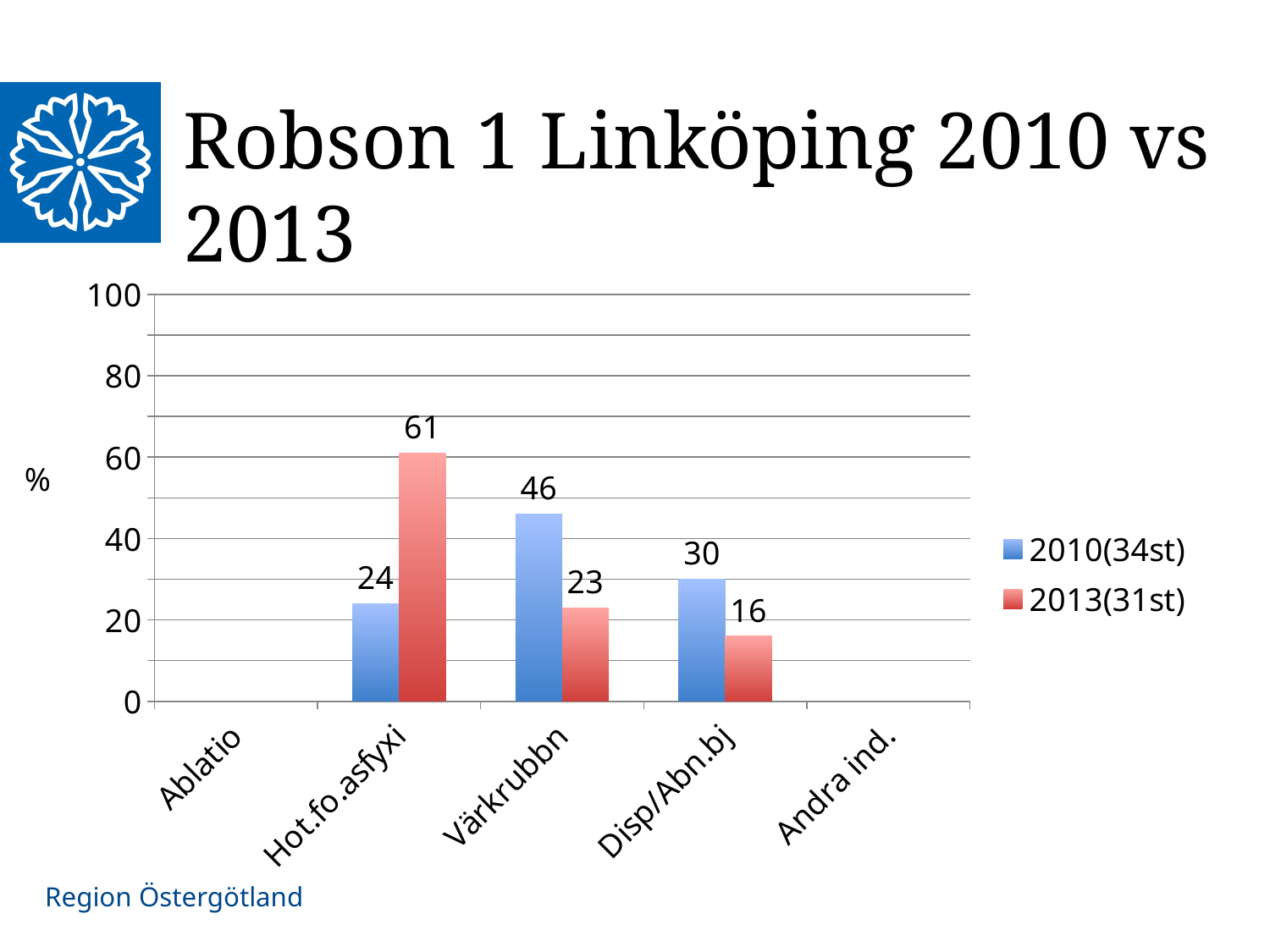
How many categories are shown on the x axis? 5 Which category has the highest value in the 2010(34st) series? Värkrubbn What is the difference between the 2010(34st) and 2013(31st) values for Värkrubbn? 23 How many series does the legend list? 2 What is the value for Hot.fo.asfyxi in the 2013(31st) series? 61 What is the value for Värkrubbn in the 2010(34st) series? 46 Which category has the highest value in the 2013(31st) series? Hot.fo.asfyxi Is the 2013(31st) value for Hot.fo.asfyxi greater or less than 40? greater What kind of chart is shown on the slide? bar chart What is the value for Disp/Abn.bj in the 2013(31st) series? 16 What is the difference between the 2013(31st) and 2010(34st) values for Hot.fo.asfyxi? 37 Which is larger for Disp/Abn.bj, the 2010(34st) value or the 2013(31st) value? 2010(34st)